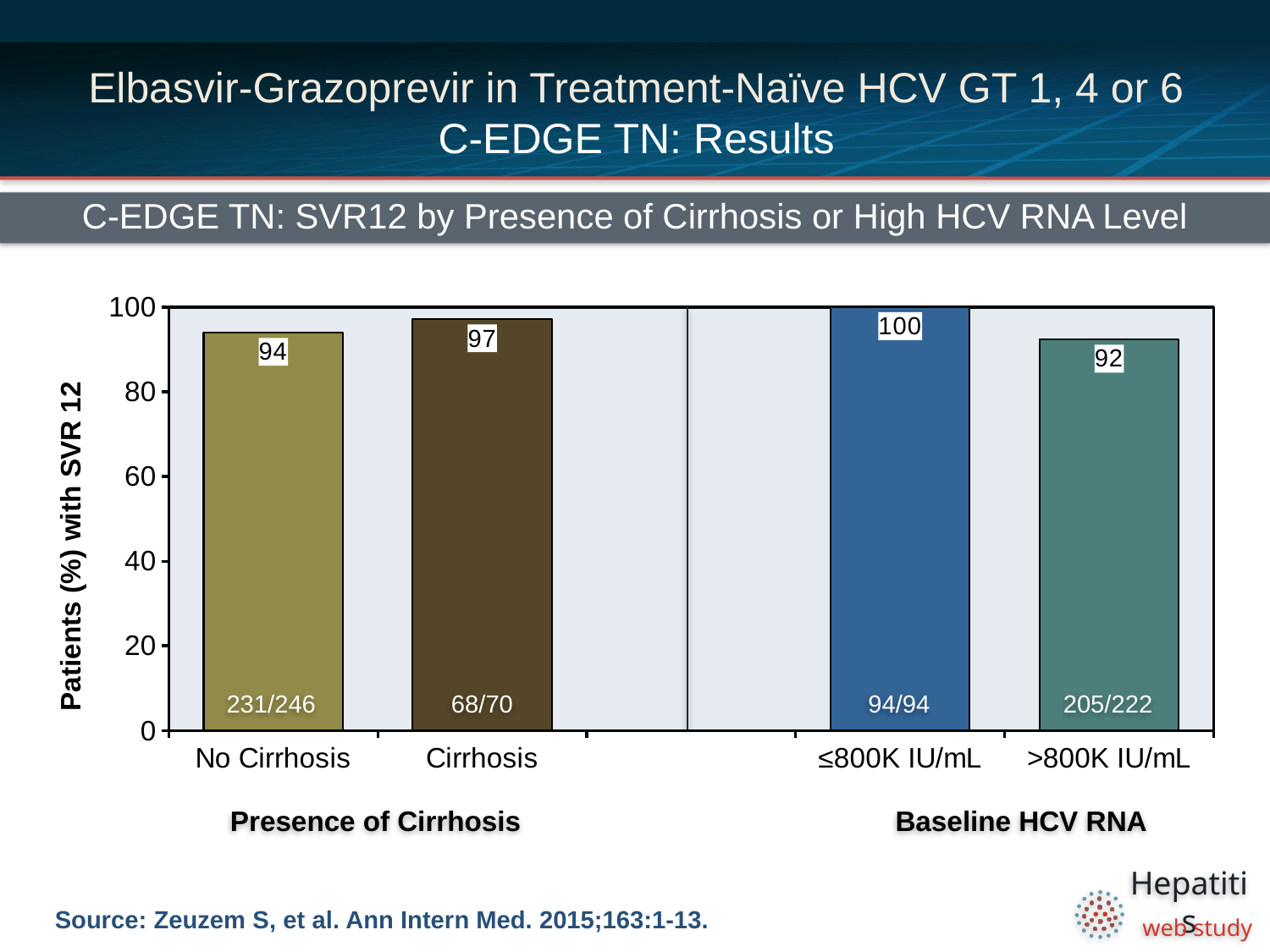
How many patients achieved SVR12 out of the total in the No Cirrhosis group, as shown on the bar? 231/246 What is the SVR12 rate for patients with baseline HCV RNA >800K IU/mL? 92 What is the SVR12 rate for the Cirrhosis group? 97 What is the difference in SVR12 rate between the Cirrhosis and No Cirrhosis groups? 3 What fraction is shown on the >800K IU/mL bar? 205/222 What type of chart is shown on the slide? Bar chart What is the SVR12 rate for the No Cirrhosis group? 94 How many bars are shown in the chart? 4 What is the SVR12 rate for patients with baseline HCV RNA ≤800K IU/mL? 100 Which has a higher SVR12 rate, ≤800K IU/mL or >800K IU/mL? ≤800K IU/mL Which category has the highest SVR12 rate? ≤800K IU/mL Which category has the lowest SVR12 rate? >800K IU/mL